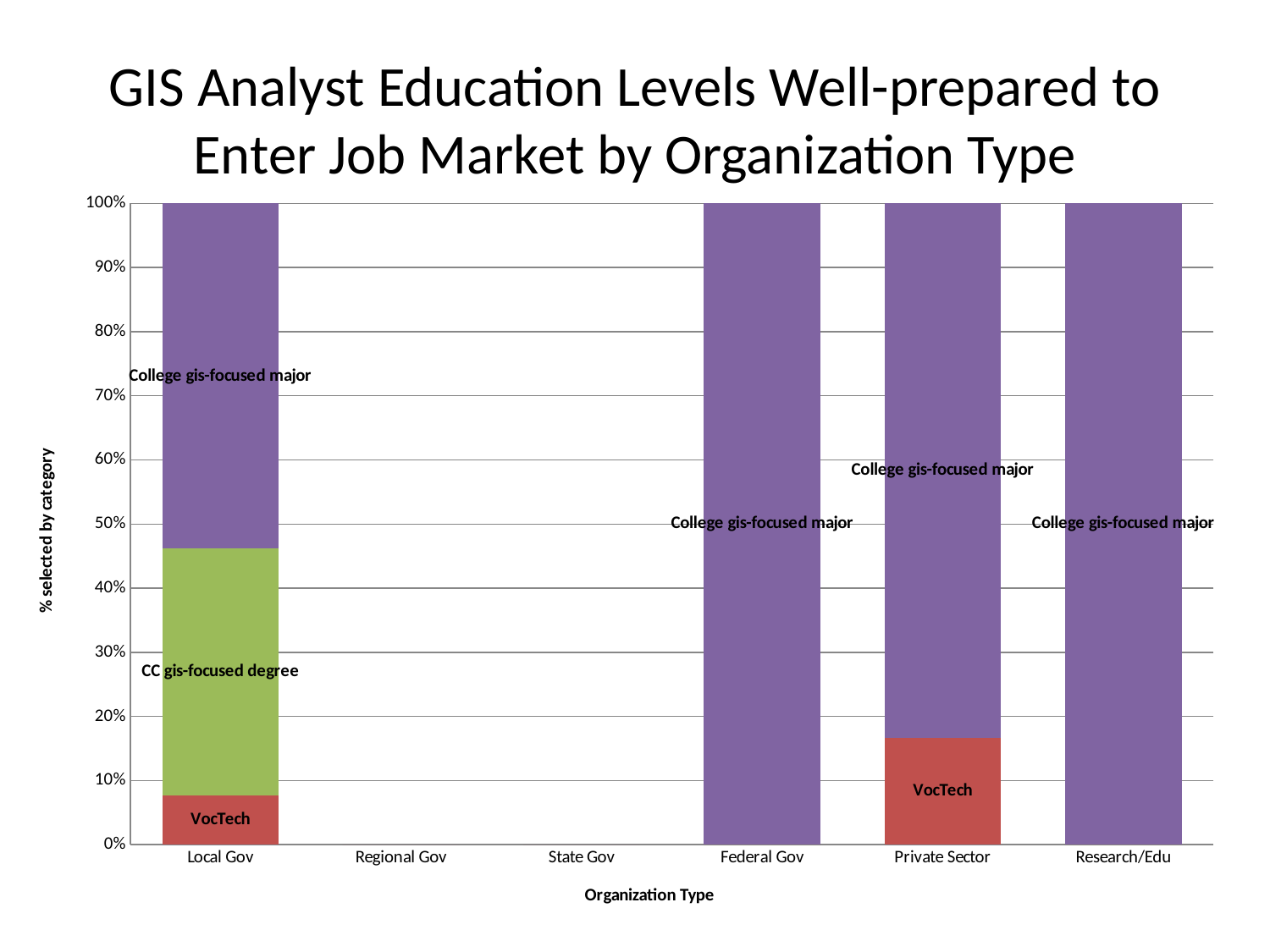
Is the College gis-focused major value for Local Gov greater or less than 50%? greater What is the title of the y axis? % selected by category Is the CC gis-focused degree value for Local Gov greater or less than 30%? greater Is the VocTech value for Local Gov greater or less than 10%? less Which organization types have no bar plotted? Regional Gov and State Gov What kind of chart is shown on the slide? Stacked bar chart Which has the larger VocTech share, Local Gov or Private Sector? Private Sector How many organization types are listed along the x axis? 6 How many segments make up the Local Gov bar? 3 What is the value of the College gis-focused major segment for Research/Edu? 100% What is the value of the College gis-focused major segment for Federal Gov? 100%